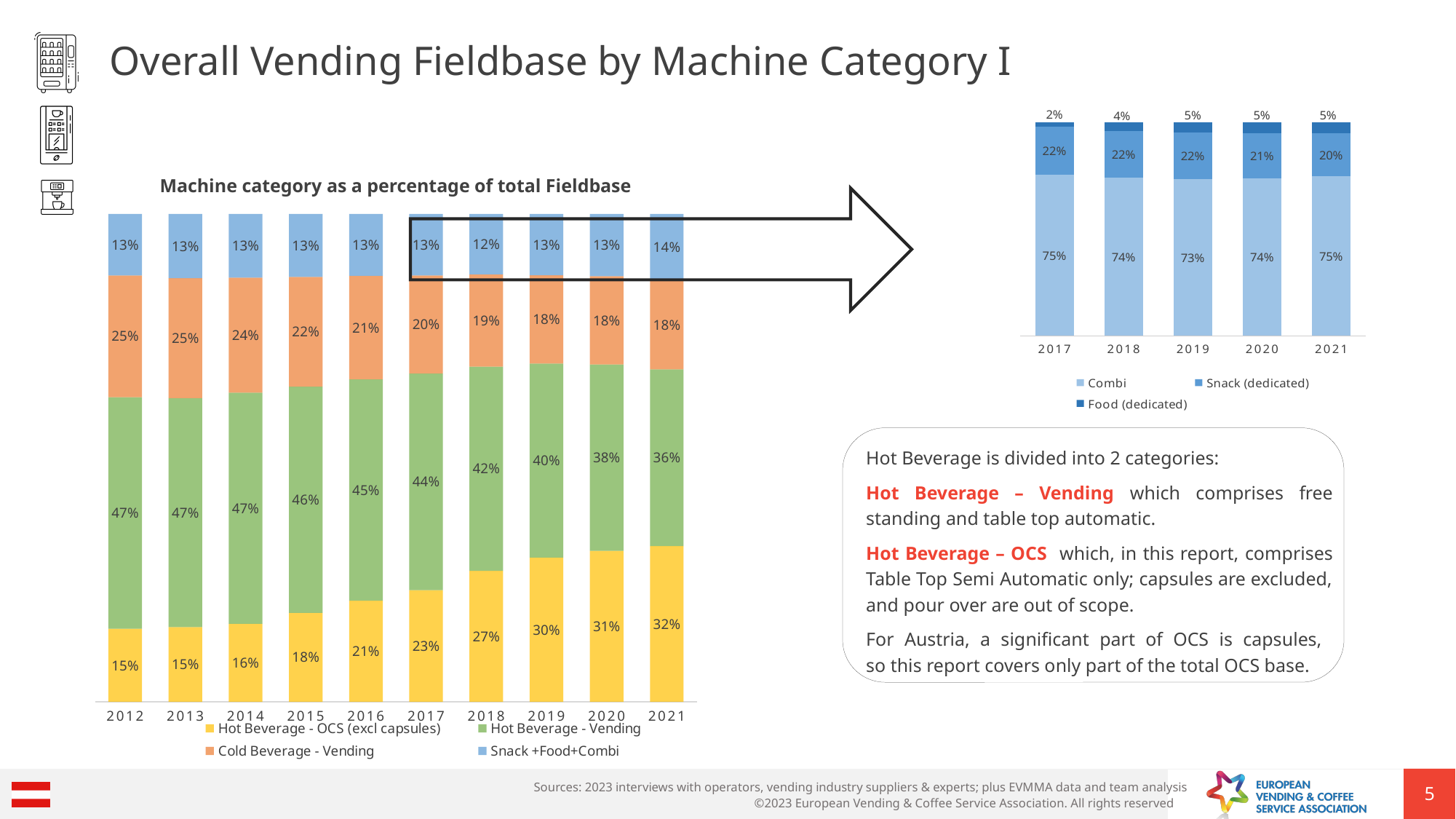
What kind of chart is the chart titled 'Machine category as a percentage of total Fieldbase'? stacked bar chart In the chart titled 'Machine category as a percentage of total Fieldbase', what is the value for Hot Beverage - OCS (excl capsules) in 2021? 32% In the chart titled 'Machine category as a percentage of total Fieldbase', what is the difference between the Hot Beverage - Vending share in 2012 and in 2021? 11 percentage points In the chart titled 'Machine category as a percentage of total Fieldbase', does Hot Beverage - OCS (excl capsules) rise or fall from 2012 to 2021? rise In the chart titled 'Machine category as a percentage of total Fieldbase', in which year is Hot Beverage - OCS (excl capsules) lowest? 2012 and 2013 (15%) In the chart at the top right of the slide, which is larger in 2021: Snack (dedicated) or Food (dedicated)? Snack (dedicated) In the chart titled 'Machine category as a percentage of total Fieldbase', how many years are shown on the x axis? 10 In the chart at the top right of the slide, what is the Combi share in 2019? 73% In the chart titled 'Machine category as a percentage of total Fieldbase', what is the value for Cold Beverage - Vending in 2016? 21% In the chart titled 'Machine category as a percentage of total Fieldbase', how many series does the legend list? 4 In the chart titled 'Machine category as a percentage of total Fieldbase', what is the value for Hot Beverage - Vending in 2012? 47% In the chart at the top right of the slide, what is the Food (dedicated) share in 2017? 2%